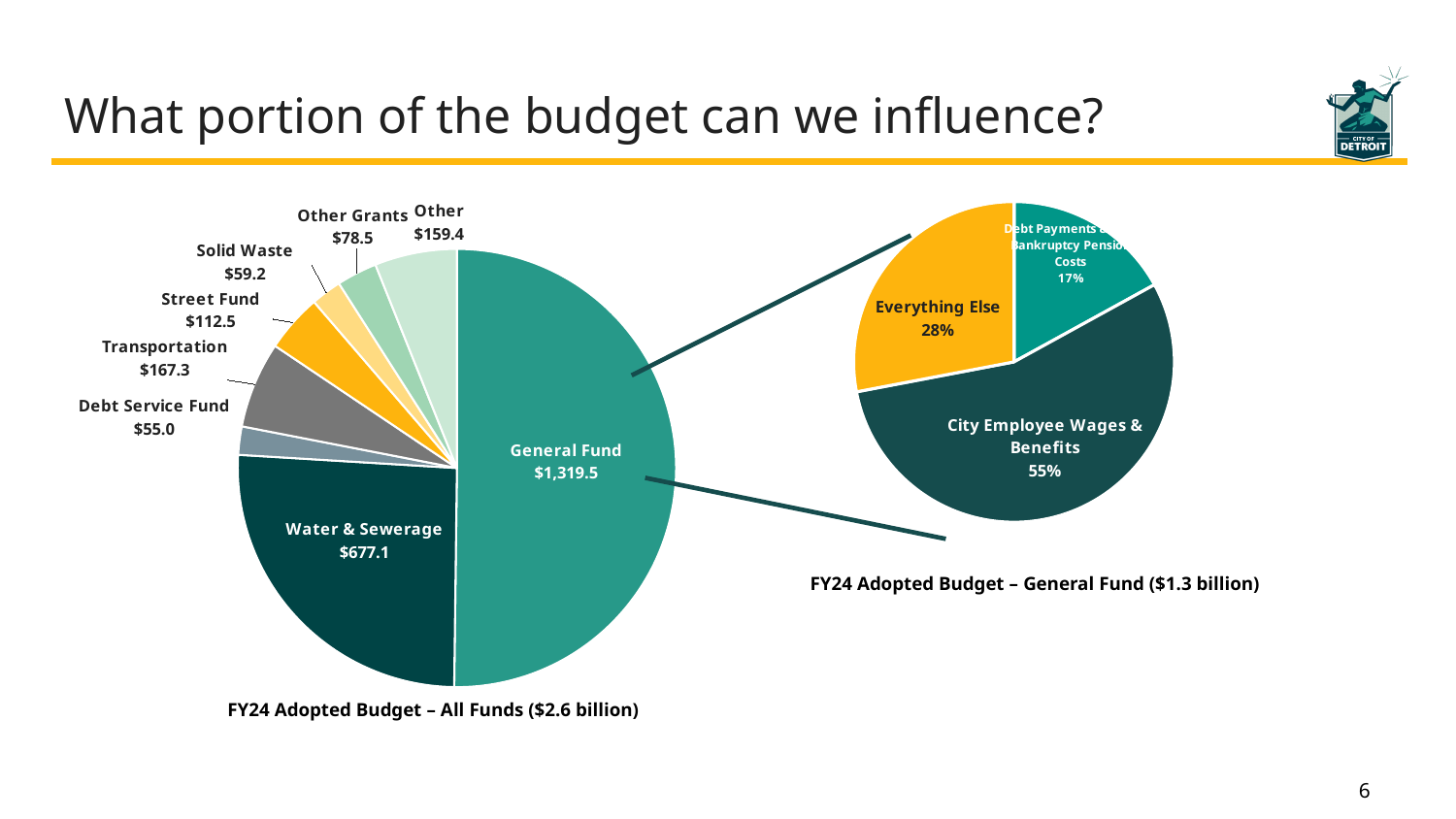
In the 'FY24 Adopted Budget – All Funds' chart, what is the difference between the General Fund and Water & Sewerage values? $642.4 In the 'FY24 Adopted Budget – All Funds' chart, what is the value for the General Fund? $1,319.5 In the 'FY24 Adopted Budget – General Fund' chart, which slice is the smallest? Debt Payments & Bankruptcy Pension Costs In the 'FY24 Adopted Budget – All Funds' chart, which fund has the smallest value? Debt Service Fund In the 'FY24 Adopted Budget – All Funds' chart, what is the value for Water & Sewerage? $677.1 In the 'FY24 Adopted Budget – All Funds' chart, which is larger: Street Fund or Other Grants? Street Fund What type of chart is the 'FY24 Adopted Budget – General Fund' chart? Pie chart In the 'FY24 Adopted Budget – General Fund' chart, what share of the pie is Everything Else? 28% How many slices does the 'FY24 Adopted Budget – All Funds' chart have? 8 In the 'FY24 Adopted Budget – All Funds' chart, which fund has the largest value? General Fund In the 'FY24 Adopted Budget – All Funds' chart, what is the value for Transportation? $167.3 In the 'FY24 Adopted Budget – General Fund' chart, what share of the pie is City Employee Wages & Benefits? 55%